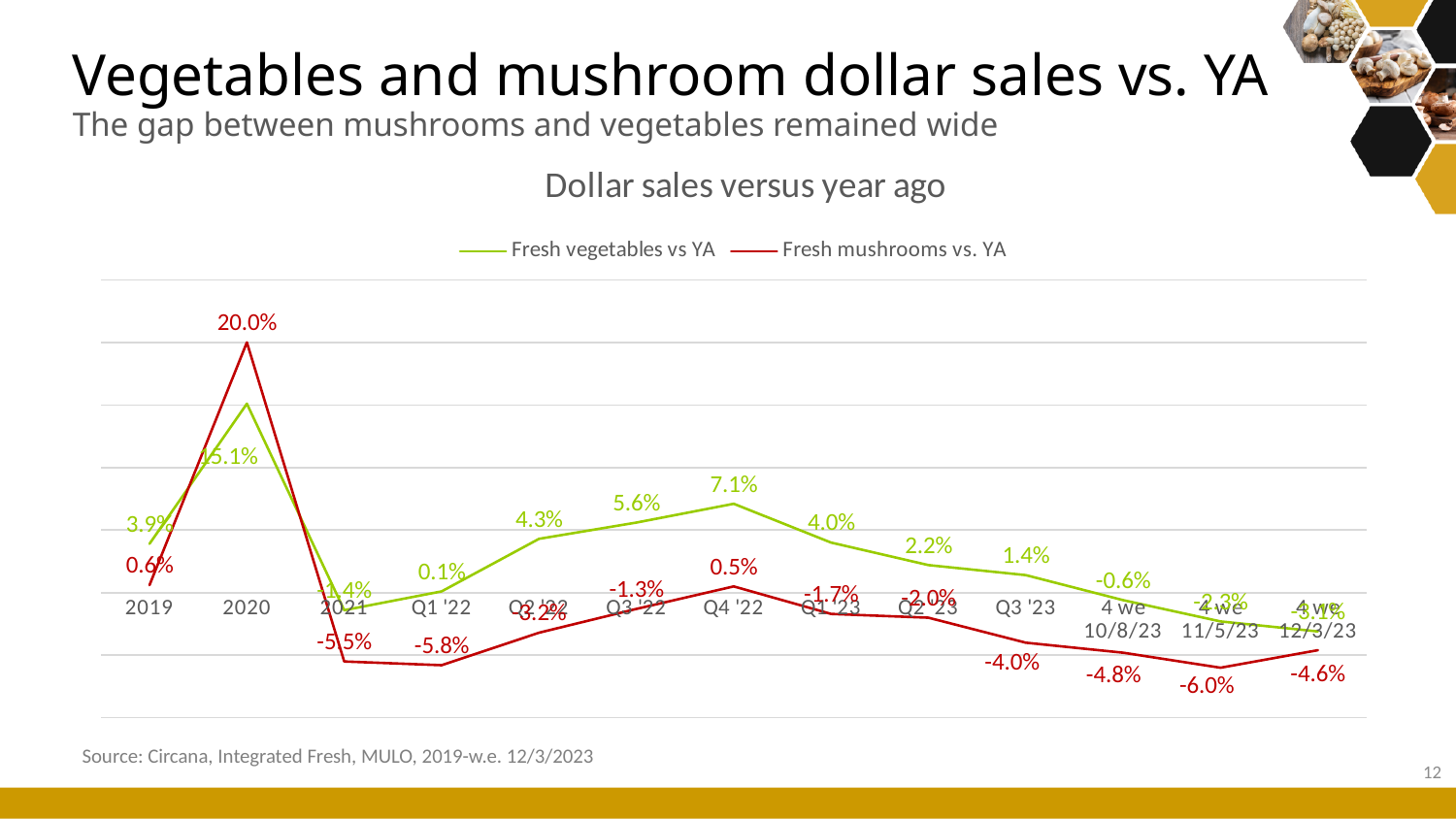
Does Fresh vegetables vs YA rise or fall from Q4 '22 to 4 we 12/3/23? Fall In 2020, how much higher is Fresh mushrooms vs. YA than Fresh vegetables vs YA? 4.9 percentage points What is the value for Fresh vegetables vs YA in Q4 '22? 7.1% In which period is Fresh mushrooms vs. YA lowest? 4 we 11/5/23 What is the value for Fresh mushrooms vs. YA in 2020? 20.0% How many periods are shown on the x axis? 13 How many series does the legend list? 2 In which period is Fresh vegetables vs YA highest? 2020 What colour is the line for Fresh mushrooms vs. YA? Red What kind of chart is shown on the slide? Line chart What is the value for Fresh mushrooms vs. YA in Q3 '23? -4.0% In Q3 '22, which series has the larger value, Fresh vegetables vs YA or Fresh mushrooms vs. YA? Fresh vegetables vs YA